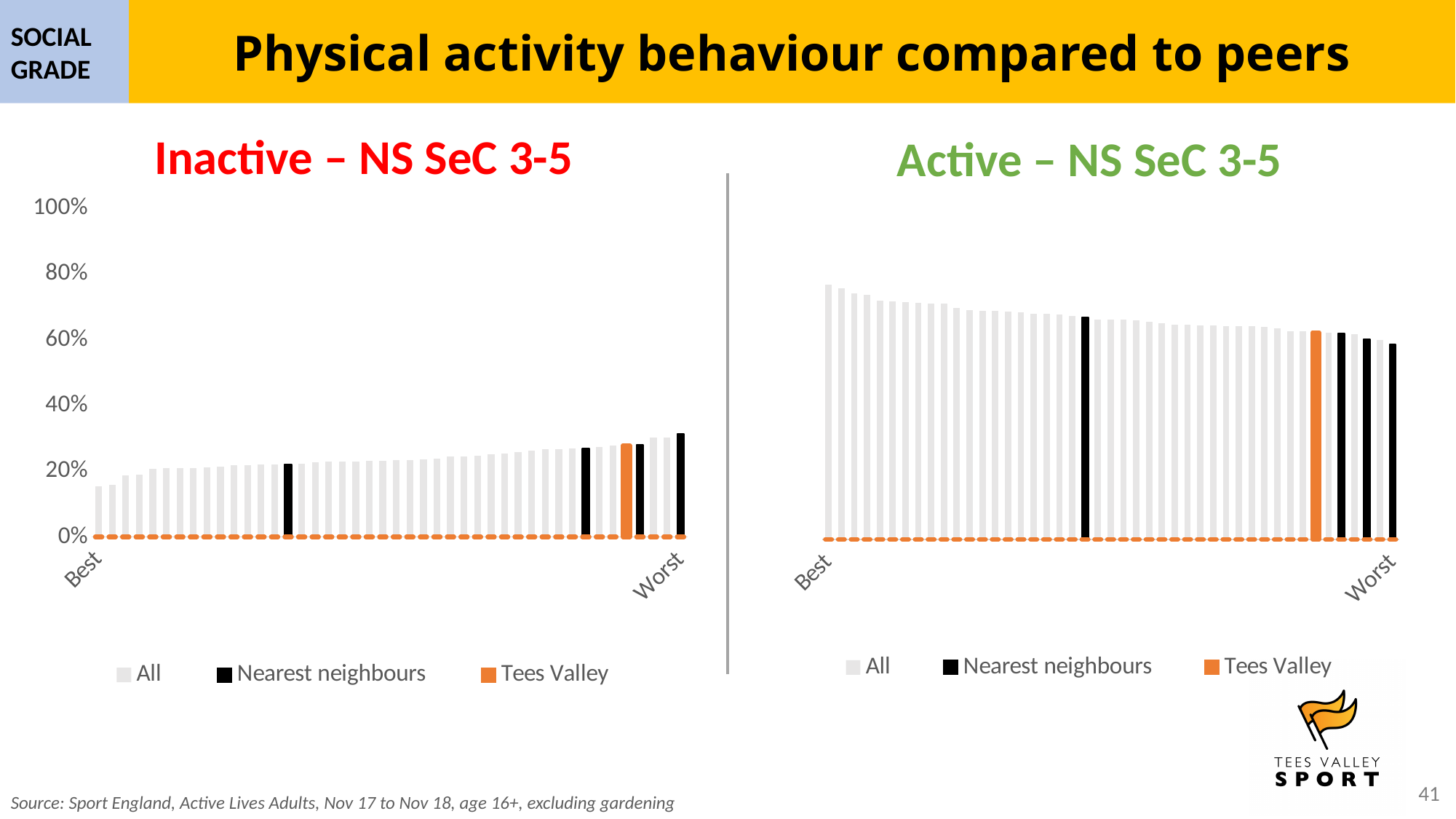
In the 'Inactive – NS SeC 3-5' chart, is the value for Tees Valley greater or less than 20%? greater In the 'Inactive – NS SeC 3-5' chart, do the values rise or fall from Best to Worst? rise In the 'Inactive – NS SeC 3-5' chart, is the value for Tees Valley greater or less than 40%? less In the 'Active – NS SeC 3-5' chart, is the value for Tees Valley greater or less than 40%? greater How many series does the legend of the 'Active – NS SeC 3-5' chart list? 3 In the 'Inactive – NS SeC 3-5' chart, how many 'Nearest neighbours' bars are shown? 4 What kind of chart is the 'Inactive – NS SeC 3-5' chart? bar chart In the 'Active – NS SeC 3-5' chart, do the values rise or fall from Best to Worst? fall In the 'Inactive – NS SeC 3-5' chart, which is larger: the Tees Valley bar or the first bar at 'Best'? Tees Valley Which series is shown in orange in the legends of both charts? Tees Valley